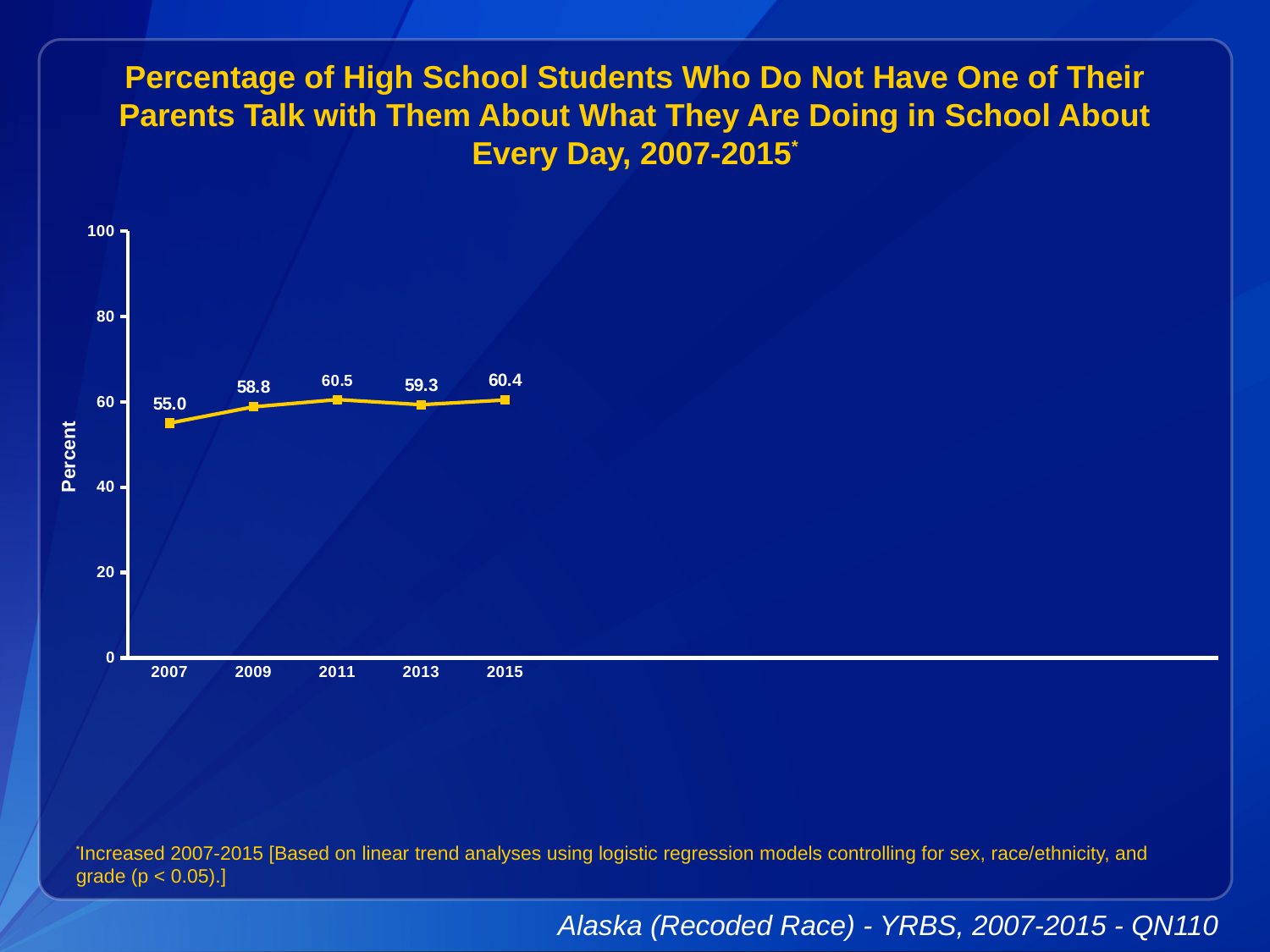
What is the value for 2013? 59.3 What is the value for 2015? 60.4 What is the difference between the values for 2015 and 2007? 5.4 Which year has the lowest value? 2007 What is the value for 2007? 55.0 Is the value for 2007 greater or less than 60? less What is the label on the vertical axis? Percent What is the value for 2011? 60.5 How many years are plotted on the chart? 5 Does the value rise or fall from 2007 to 2009? rise Which is larger, the value for 2009 or the value for 2013? 2013 What kind of chart is shown on the slide? line chart